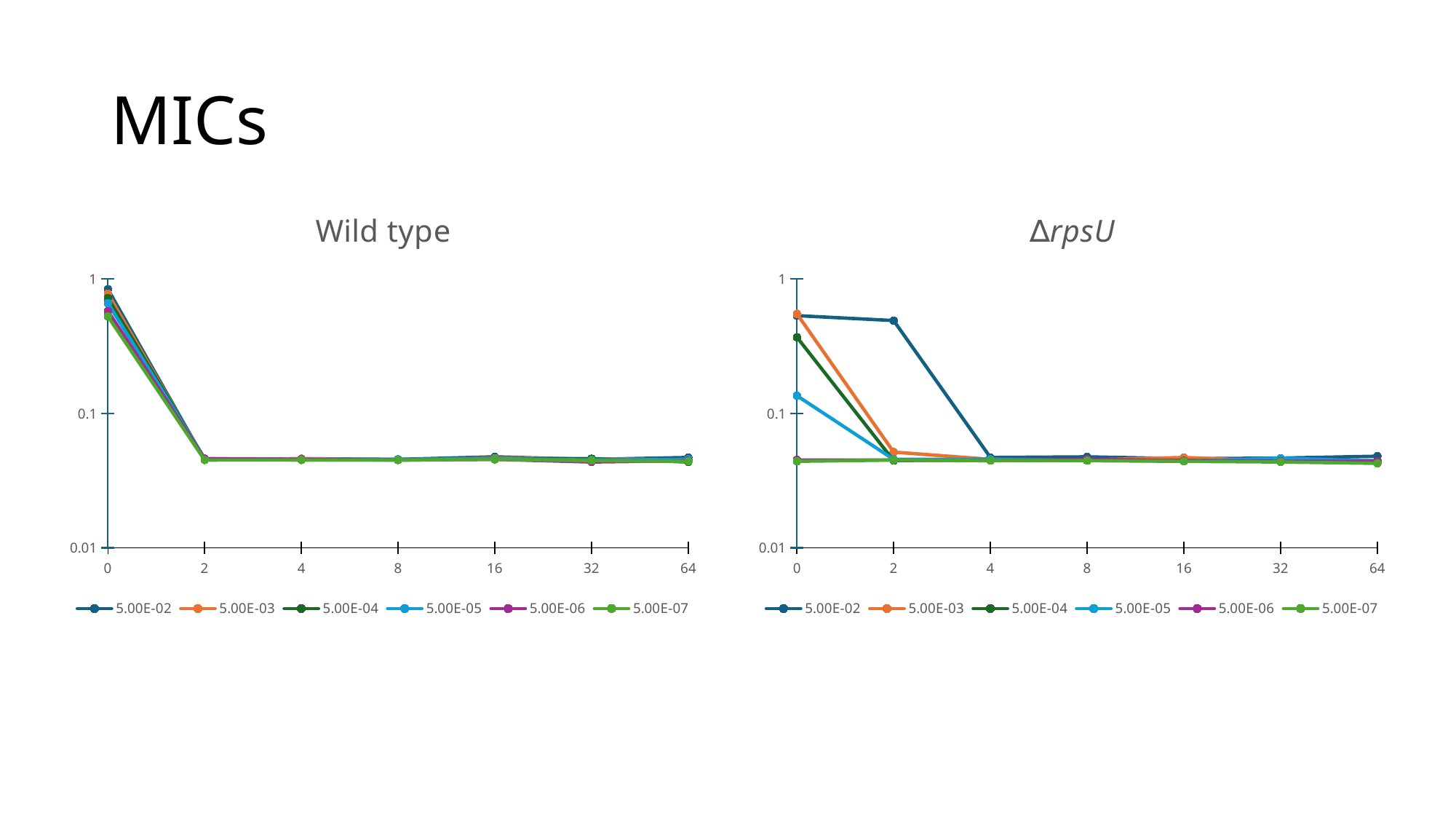
How many x-axis points are plotted on the Wild type chart? 7 In the ΔrpsU chart, is the value for 5.00E-02 at x = 4 greater or less than 0.1? less In the ΔrpsU chart, which series has the highest value at x = 2? 5.00E-02 What is the title of the right-hand chart? ΔrpsU In the Wild type chart, is the value for 5.00E-02 at x = 0 greater or less than 0.1? greater In the Wild type chart, is the value for 5.00E-03 at x = 2 greater or less than 0.1? less How many series does the legend of the ΔrpsU chart list? 6 What kind of chart is the Wild type chart? line chart In the ΔrpsU chart, at x = 0, which is larger: the value for 5.00E-04 or the value for 5.00E-05? 5.00E-04 In the Wild type chart, do the values for 5.00E-02 rise or fall from x = 0 to x = 2? fall